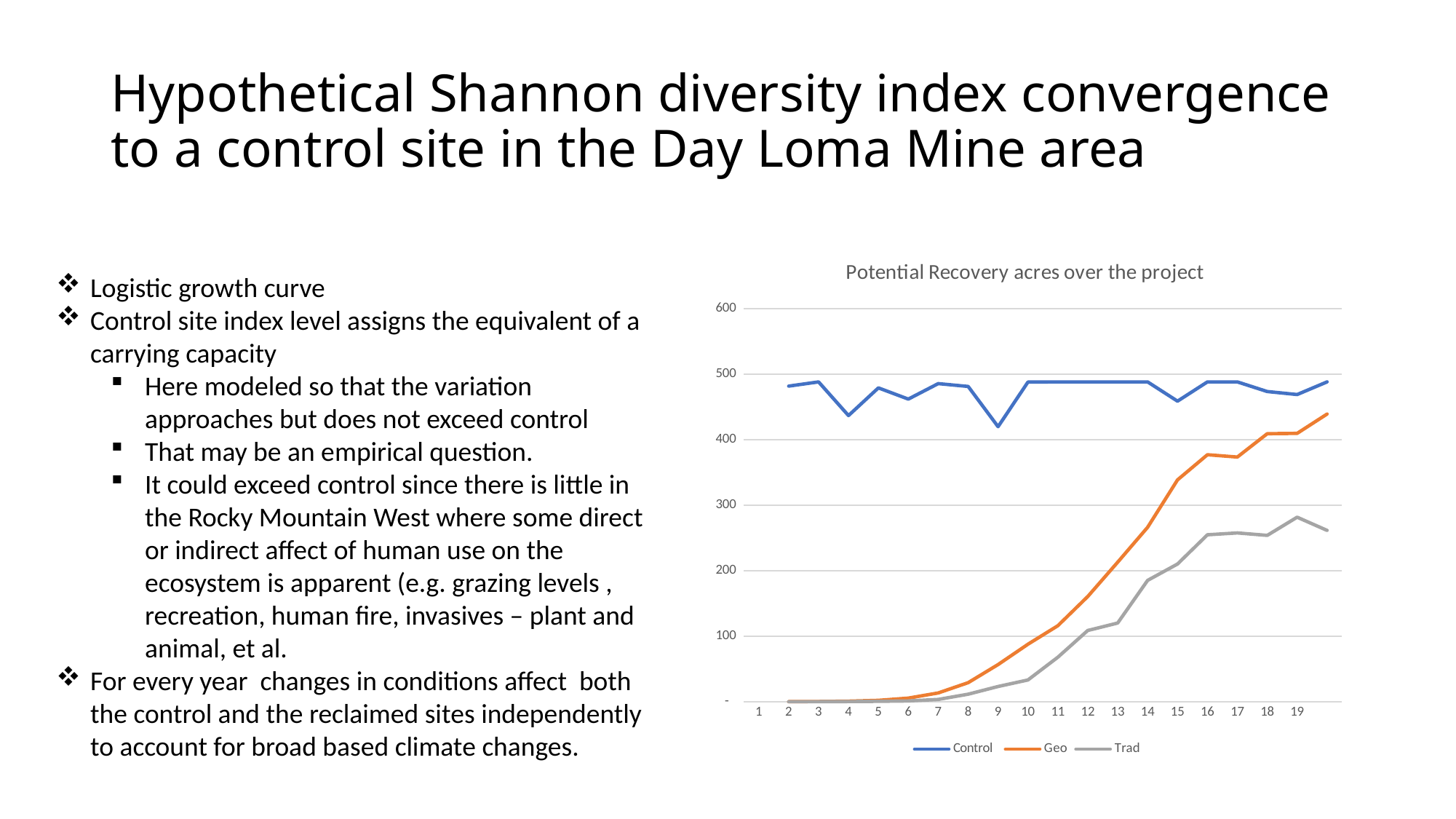
What is the title of the chart? Potential Recovery acres over the project How many series does the chart's legend list? 3 Is the value for Control at x = 4 greater or less than 400? greater Does the Geo series rise or fall as the x axis increases? rises Which series has the highest value at x = 10? Control At x = 19, which is larger, the Geo value or the Trad value? Geo Which series has the lowest value at x = 19? Trad Is the value for Geo at x = 15 greater or less than 300? greater Is the value for Trad at x = 14 greater or less than 200? less Which series is shown in orange in the chart? Geo What kind of chart is shown on the slide? line chart At x = 15, which is larger, the Control value or the Geo value? Control